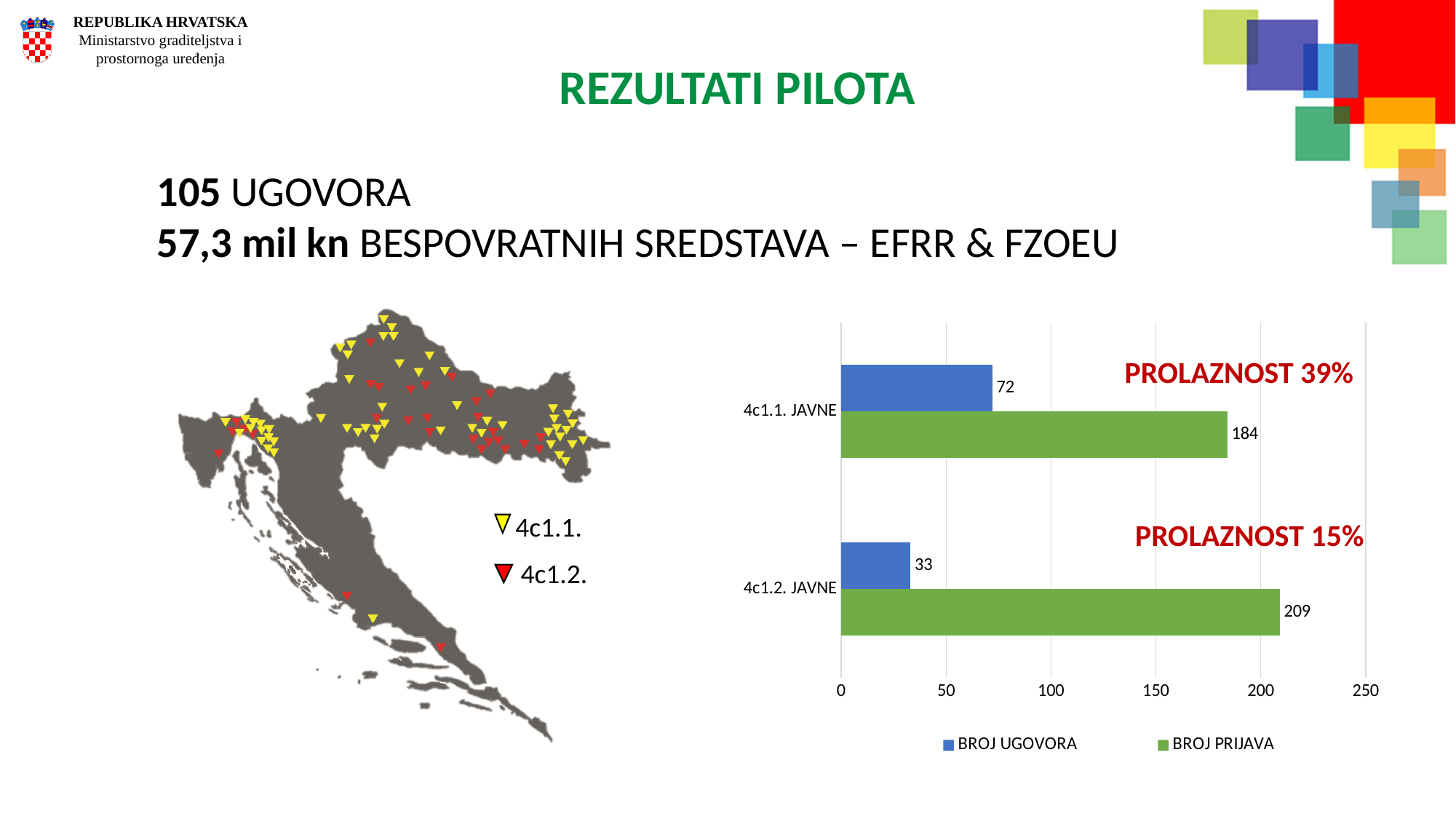
What is the BROJ UGOVORA value for 4c1.1. JAVNE? 72 What kind of chart is shown on the right of the slide? bar chart What is the difference between BROJ PRIJAVA and BROJ UGOVORA for 4c1.1. JAVNE? 112 Which category has the lower BROJ UGOVORA value? 4c1.2. JAVNE What is the BROJ UGOVORA value for 4c1.2. JAVNE? 33 What is the difference in BROJ UGOVORA between 4c1.1. JAVNE and 4c1.2. JAVNE? 39 What PROLAZNOST percentage is shown next to the 4c1.1. JAVNE bars? 39% What is the BROJ PRIJAVA value for 4c1.1. JAVNE? 184 How many series does the chart legend list? 2 What is the BROJ PRIJAVA value for 4c1.2. JAVNE? 209 Is the BROJ UGOVORA value for 4c1.1. JAVNE larger or smaller than the BROJ UGOVORA value for 4c1.2. JAVNE? larger Which category has the higher BROJ PRIJAVA value? 4c1.2. JAVNE